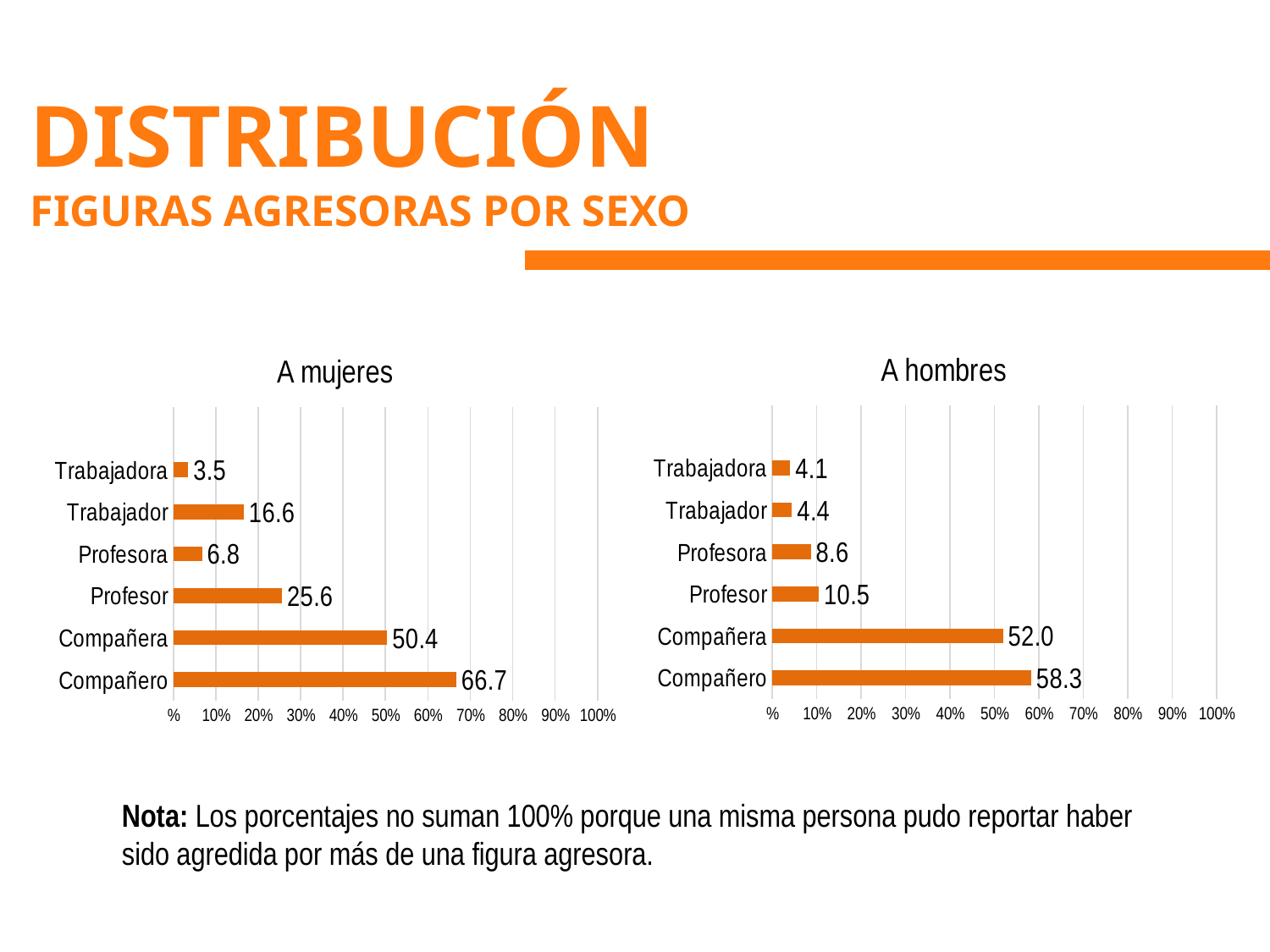
In the 'A hombres' chart, which category has the highest value? Compañero In the 'A hombres' chart, what is the value for Profesor? 10.5 How many categories are shown in the 'A hombres' chart? 6 In the 'A hombres' chart, which category has the lowest value? Trabajadora What kind of chart is the 'A mujeres' chart? Bar chart In the 'A mujeres' chart, which category has the lowest value? Trabajadora In the 'A mujeres' chart, which is larger, the value for Profesor or the value for Trabajador? Profesor In the 'A mujeres' chart, what is the value for Compañero? 66.7 In the 'A hombres' chart, what is the difference between the values for Compañera and Profesor? 41.5 In the 'A mujeres' chart, what is the difference between the values for Compañero and Compañera? 16.3 What is the title of the chart on the right side of the slide? A hombres In the 'A mujeres' chart, what is the value for Trabajador? 16.6